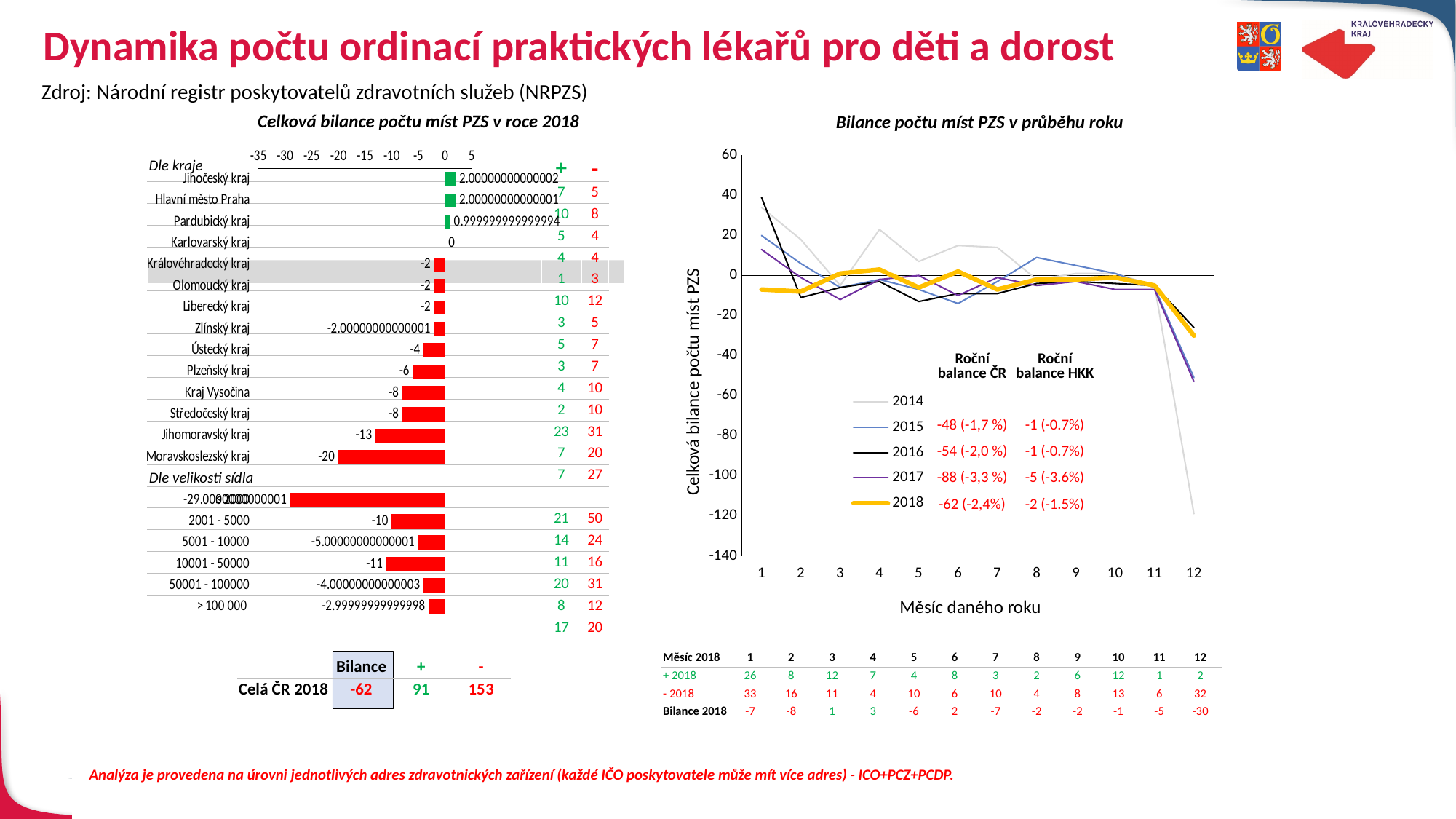
In the chart 'Bilance počtu míst PZS v průběhu roku', how many months are shown on the x axis? 12 How many series does the legend of the chart 'Bilance počtu míst PZS v průběhu roku' list? 5 In the chart 'Bilance počtu míst PZS v průběhu roku', is the value for 2014 in month 12 greater or less than -100? less In the chart 'Celková bilance počtu míst PZS v roce 2018', which region (kraj) has the lowest value? Moravskoslezský kraj In the chart 'Celková bilance počtu míst PZS v roce 2018', what is the value for the settlement size category 10001 - 50000? -11 In the chart 'Celková bilance počtu míst PZS v roce 2018', what is the value for Jihomoravský kraj? -13 In the chart 'Celková bilance počtu míst PZS v roce 2018', what is the value for Karlovarský kraj? 0 In the chart 'Bilance počtu míst PZS v průběhu roku', is the value for 2016 in month 1 greater or less than 20? greater What type of chart is 'Celková bilance počtu míst PZS v roce 2018'? bar chart In the chart 'Celková bilance počtu míst PZS v roce 2018', what is the difference between the values for Kraj Vysočina and Moravskoslezský kraj? 12 In the chart 'Celková bilance počtu míst PZS v roce 2018', which is larger: the value for Plzeňský kraj or the value for Ústecký kraj? Ústecký kraj In the chart 'Celková bilance počtu míst PZS v roce 2018', what is the value for Moravskoslezský kraj? -20